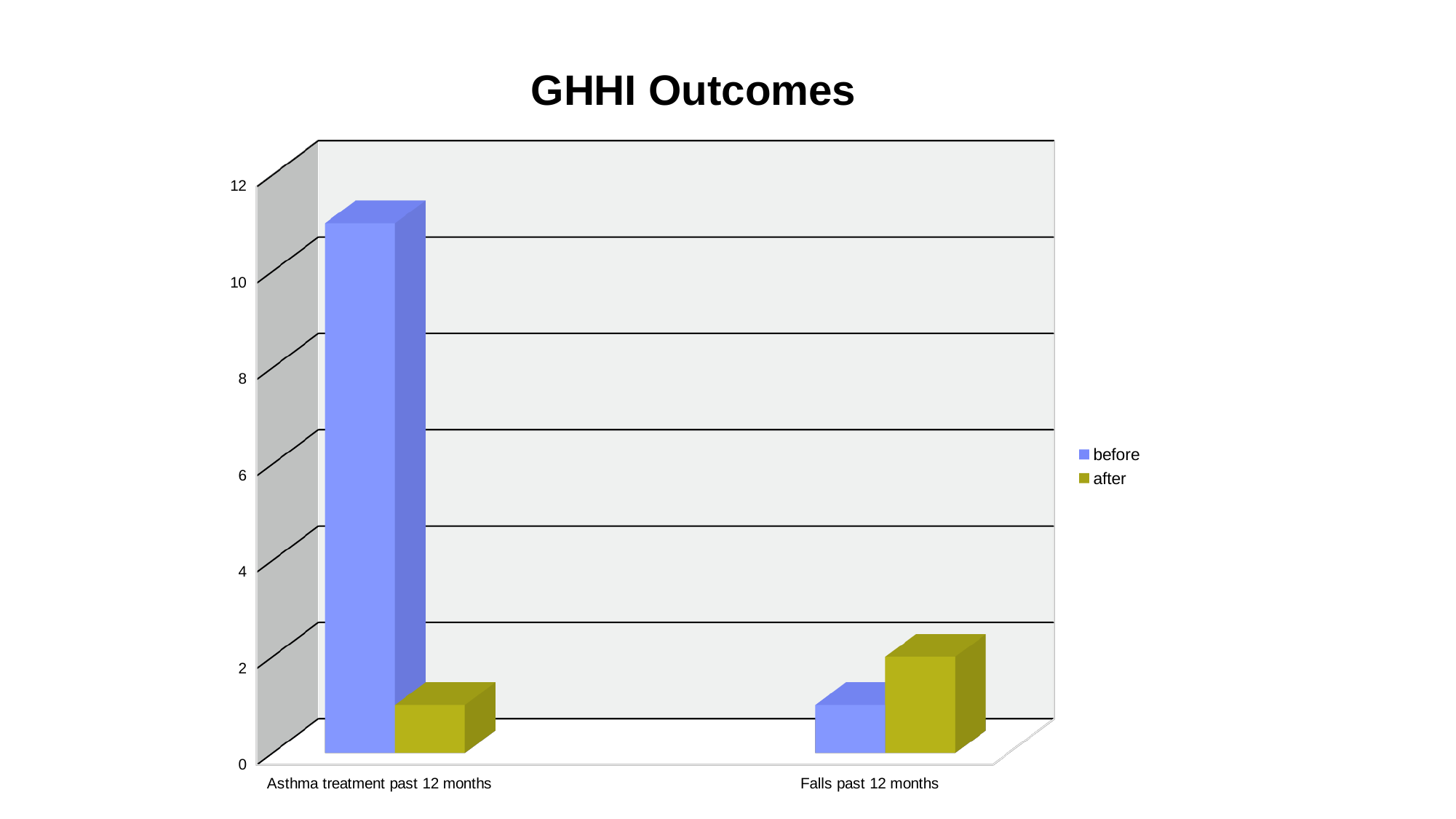
Which category and series has the highest bar? Asthma treatment past 12 months, before What is the title of the chart? GHHI Outcomes Is the 'before' value for Asthma treatment past 12 months greater or less than 8? greater Is the 'after' value for Falls past 12 months greater or less than 4? less For Falls past 12 months, which is larger: the 'before' value or the 'after' value? after Is the 'after' value for Asthma treatment past 12 months greater or less than 2? less For Asthma treatment past 12 months, which is larger: the 'before' value or the 'after' value? before Which colour represents the 'after' series in the legend? olive/yellow-green How many series does the legend list? 2 How many categories are shown on the x axis? 2 What kind of chart is shown on the slide? bar chart